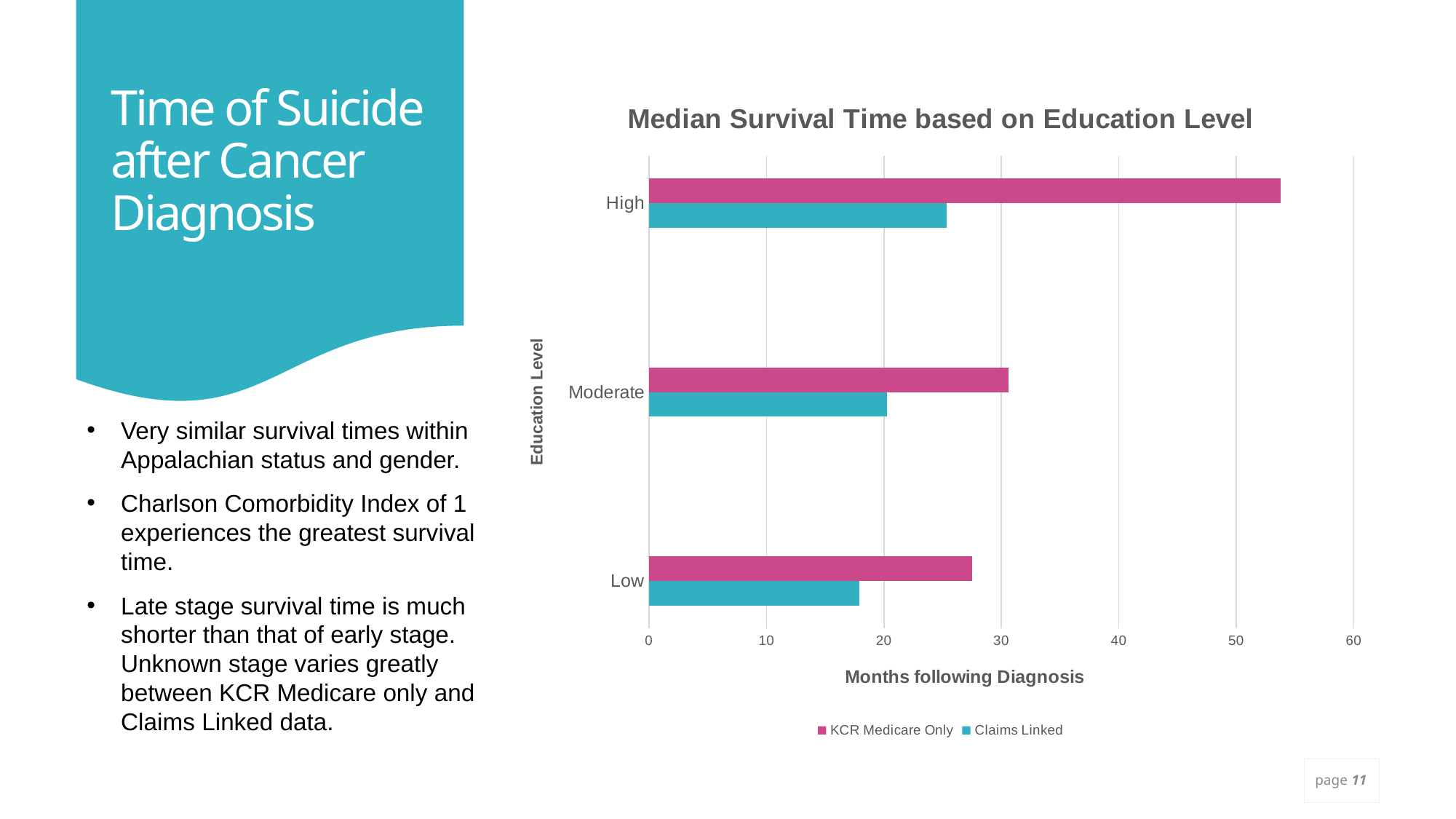
How many series does the legend list? 2 Which education level has the highest value for Claims Linked? High What type of chart is shown on the slide? bar chart What is the label of the x axis? Months following Diagnosis Which education level has the lowest value for KCR Medicare Only? Low Is the KCR Medicare Only value for Low greater or less than 30? less What is the title of the chart? Median Survival Time based on Education Level For the High education level, which series has the larger value, KCR Medicare Only or Claims Linked? KCR Medicare Only Which education level has the highest value for KCR Medicare Only? High Is the KCR Medicare Only value for High greater or less than 50? greater How many education level categories are shown on the chart? 3 Is the Claims Linked value for High greater or less than 20? greater